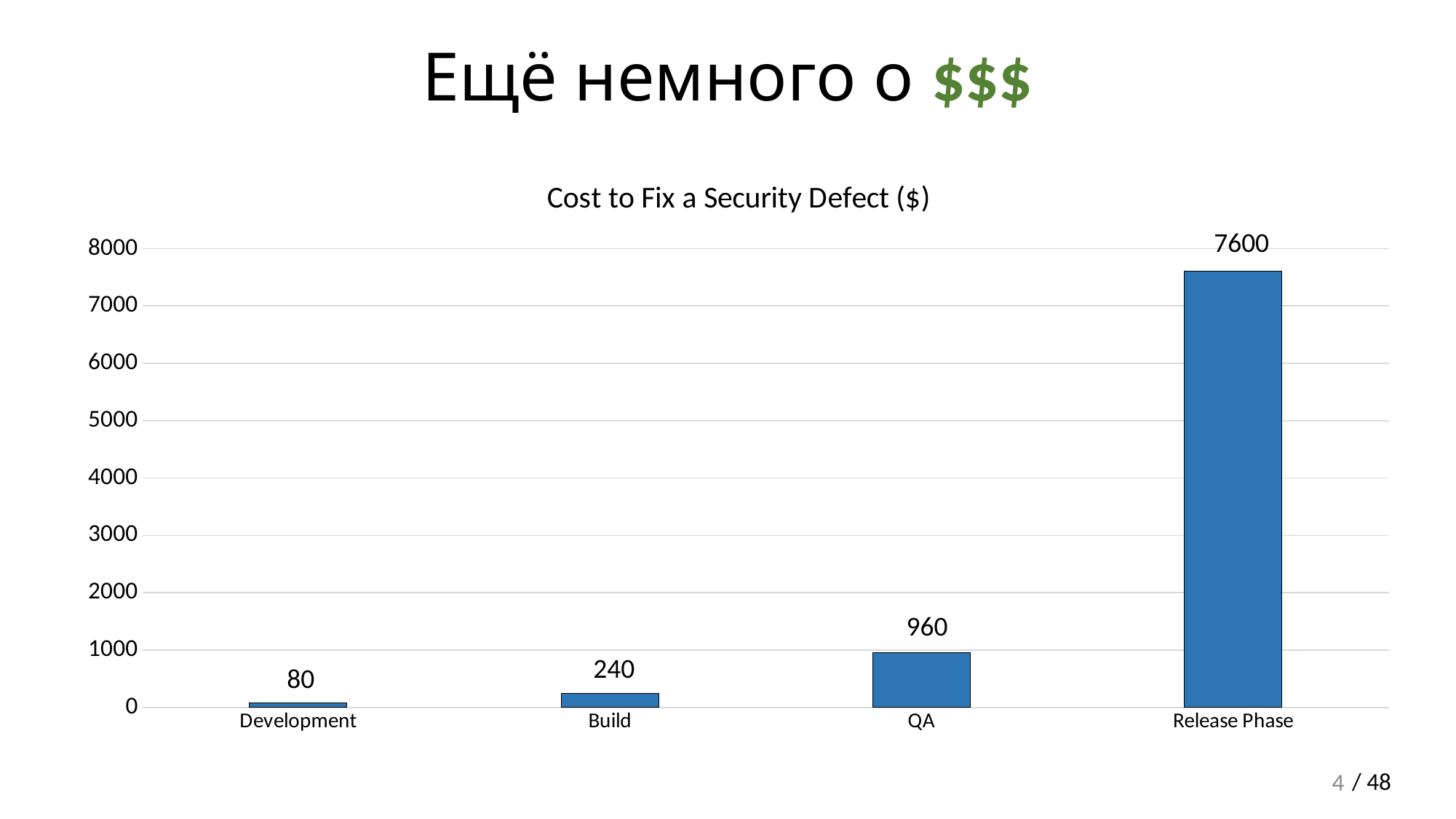
What is the title of the chart? Cost to Fix a Security Defect ($) How many phases are shown on the x axis? 4 Which is larger, the value for QA or the value for Build? QA Which phase has the highest cost to fix a security defect? Release Phase What is the cost to fix a security defect in the Development phase? 80 Which phase has the lowest cost to fix a security defect? Development What is the value shown for Build? 240 What kind of chart is shown on the slide? Bar chart What is the value shown for Release Phase? 7600 What is the value shown for QA? 960 What is the difference between the Release Phase value and the QA value? 6640 What is the difference between the Build value and the Development value? 160